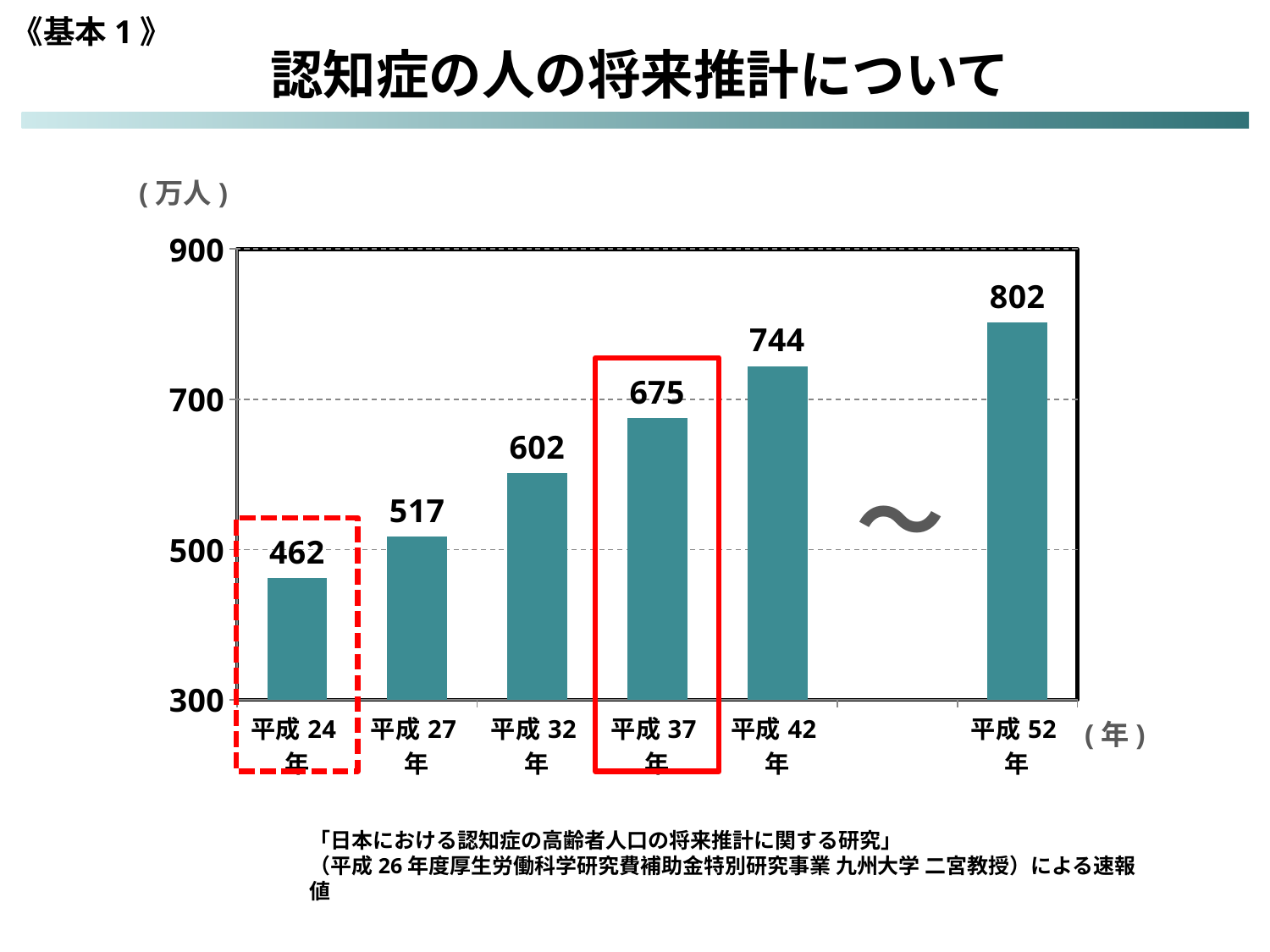
What is the difference between the values for 平成42年 and 平成37年? 69 Do the values rise or fall from 平成24年 to 平成52年? rise What is the difference between the values for 平成52年 and 平成24年? 340 Is the value for 平成42年 greater or less than 700? greater What kind of chart is shown on the slide? bar chart Which year has the lowest value? 平成24年 What is the value for 平成52年? 802 Which year has the highest value? 平成52年 Which is larger, the value for 平成27年 or the value for 平成32年? 平成32年 What is the value for 平成24年? 462 What is the value for 平成37年? 675 How many years are shown on the x axis? 6